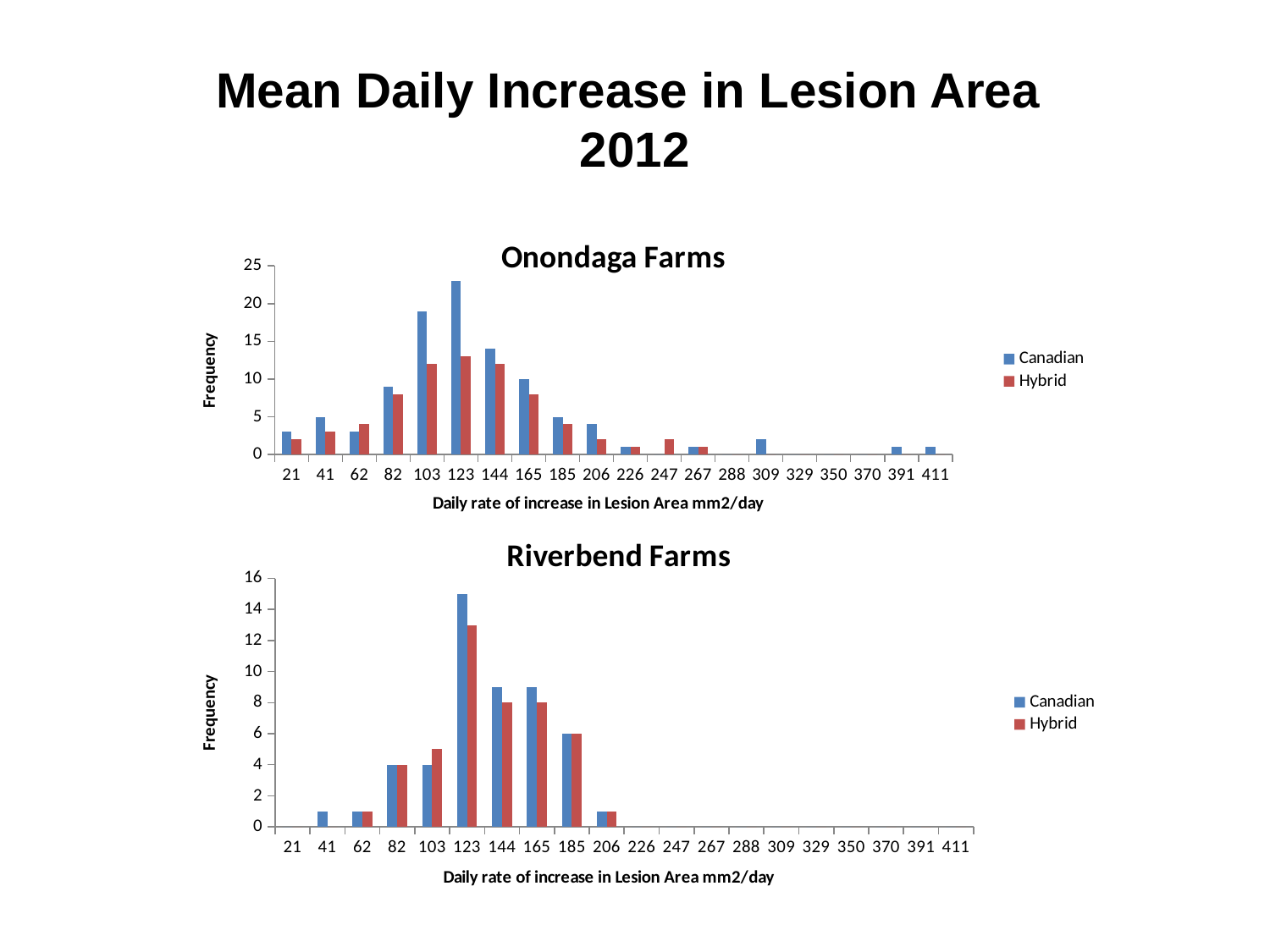
In the Onondaga Farms chart, at which daily rate category is the Canadian frequency highest? 123 In the Riverbend Farms chart, at which daily rate category is the Hybrid frequency highest? 123 In the Riverbend Farms chart, what is the Hybrid frequency at 144? 8 What is the y-axis label of the Onondaga Farms chart? Frequency What kind of chart is the Onondaga Farms chart? bar chart How many daily rate categories are shown on the x axis of the Riverbend Farms chart? 20 In the Onondaga Farms chart, which series has the larger frequency at 103, Canadian or Hybrid? Canadian How many series does the legend of the Riverbend Farms chart list? 2 In the Riverbend Farms chart, what is the Canadian frequency at 185? 6 In the Riverbend Farms chart, which series has the larger frequency at 103, Canadian or Hybrid? Hybrid In the Onondaga Farms chart, is the Hybrid frequency at 103 greater or less than 15? less In the Onondaga Farms chart, is the Canadian frequency at 123 greater or less than 20? greater